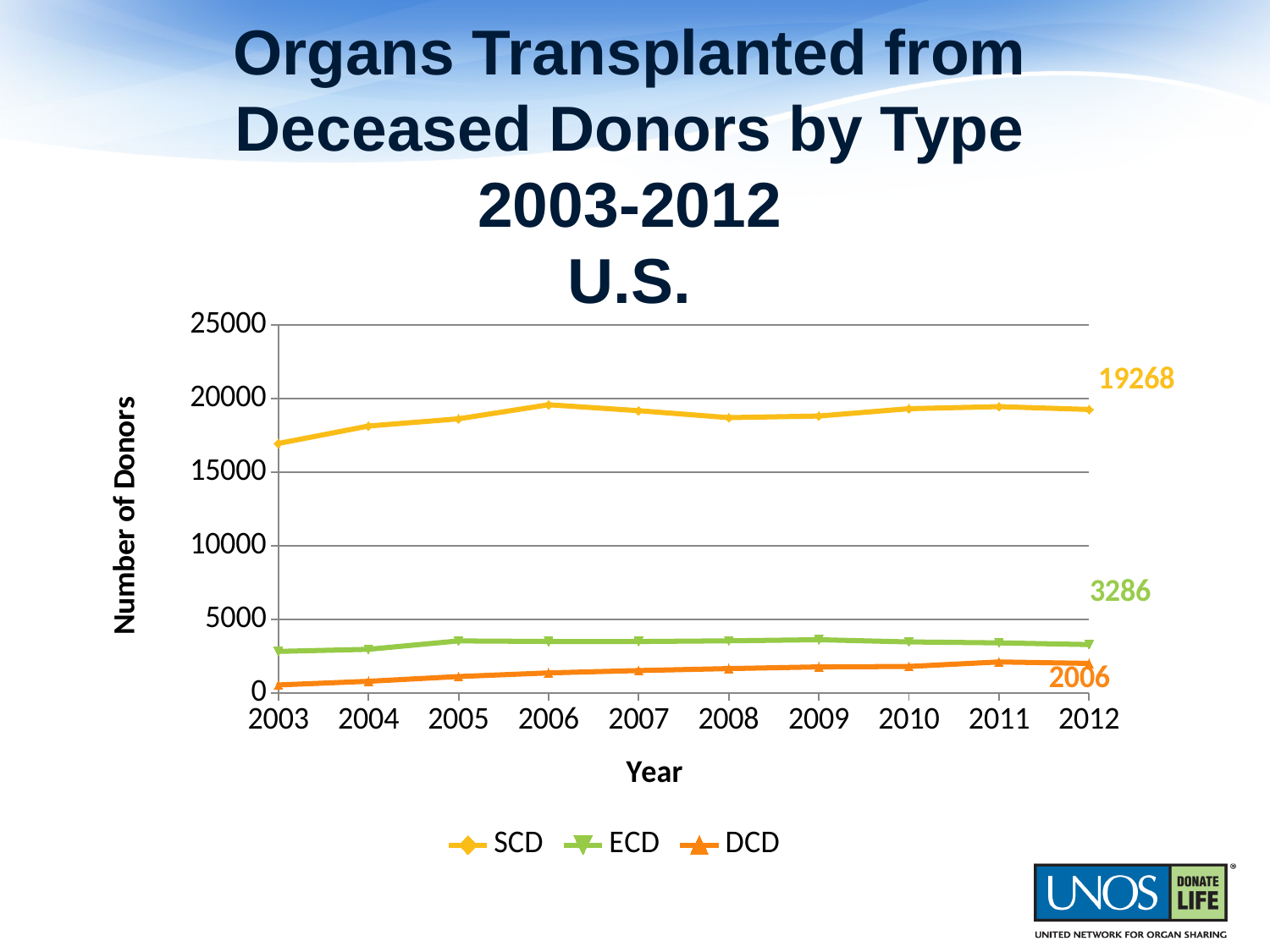
Which series has the lowest value in 2012? DCD Is the value for DCD in 2003 greater or less than 5000? less What is the difference between the SCD and ECD values in 2012? 15982 What is the value for SCD in 2012? 19268 Which series has the highest value in 2012? SCD Is the value for SCD in 2003 greater or less than 15000? greater What is the value for DCD in 2012? 2006 What is the value for ECD in 2012? 3286 What is the difference between the ECD and DCD values in 2012? 1280 What kind of chart is shown on the slide? line chart How many series does the legend list? 3 How many years are shown on the x axis? 10